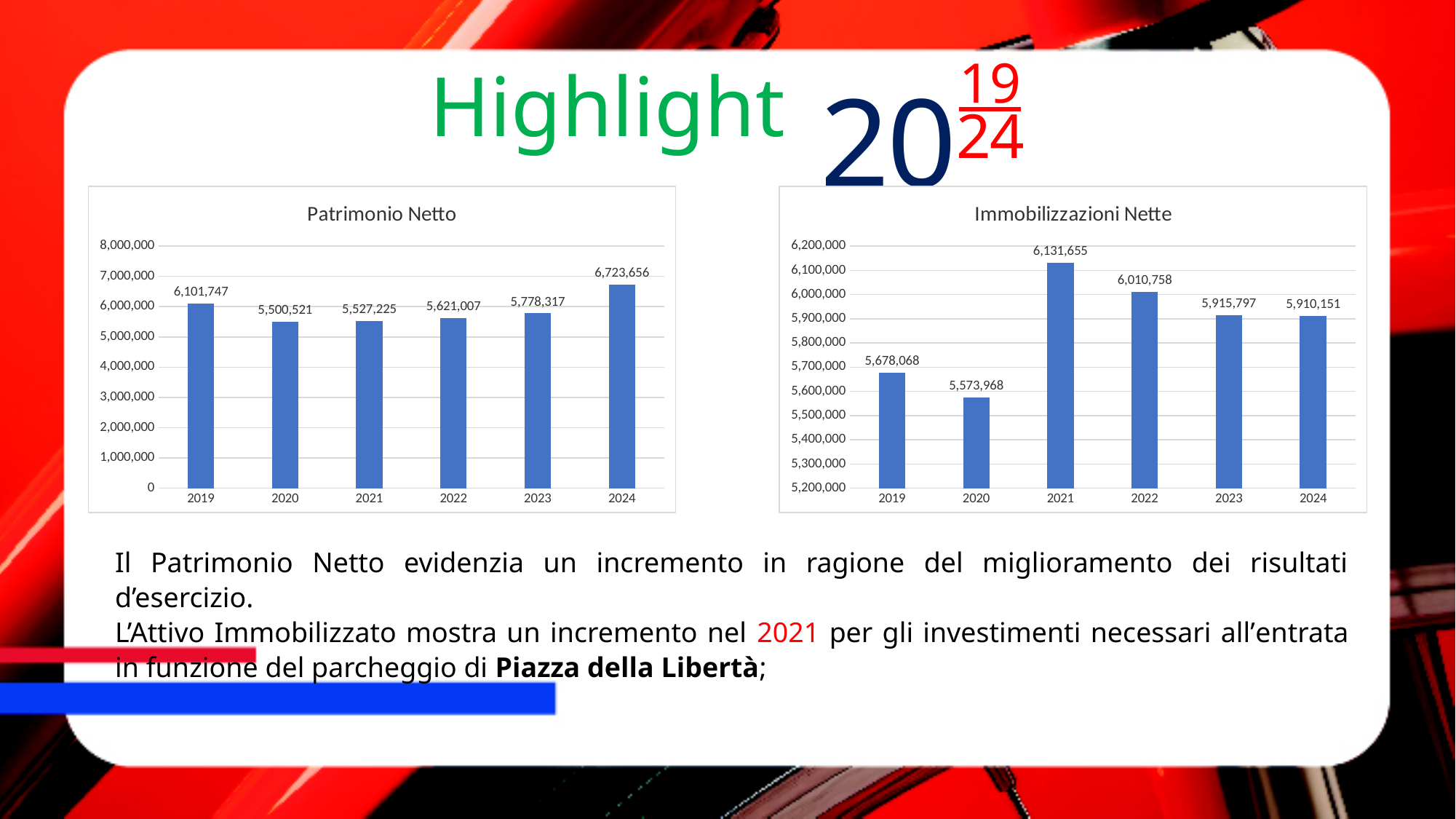
In the Immobilizzazioni Nette chart, what is the value for 2019? 5,678,068 In the Patrimonio Netto chart, what is the value for 2020? 5,500,521 In the Patrimonio Netto chart, what is the difference between the 2024 and 2019 values? 621,909 In the Immobilizzazioni Nette chart, which year has the lowest value? 2020 In the Patrimonio Netto chart, how many years are shown? 6 What kind of chart is the Immobilizzazioni Nette chart? bar chart In the Patrimonio Netto chart, which year has the lowest value? 2020 In the Immobilizzazioni Nette chart, what is the difference between the 2021 and 2020 values? 557,687 In the Patrimonio Netto chart, which year has the highest value? 2024 In the Immobilizzazioni Nette chart, is the value for 2022 larger or smaller than the value for 2023? larger In the Immobilizzazioni Nette chart, what is the value for 2021? 6,131,655 In the Patrimonio Netto chart, what is the value for 2024? 6,723,656